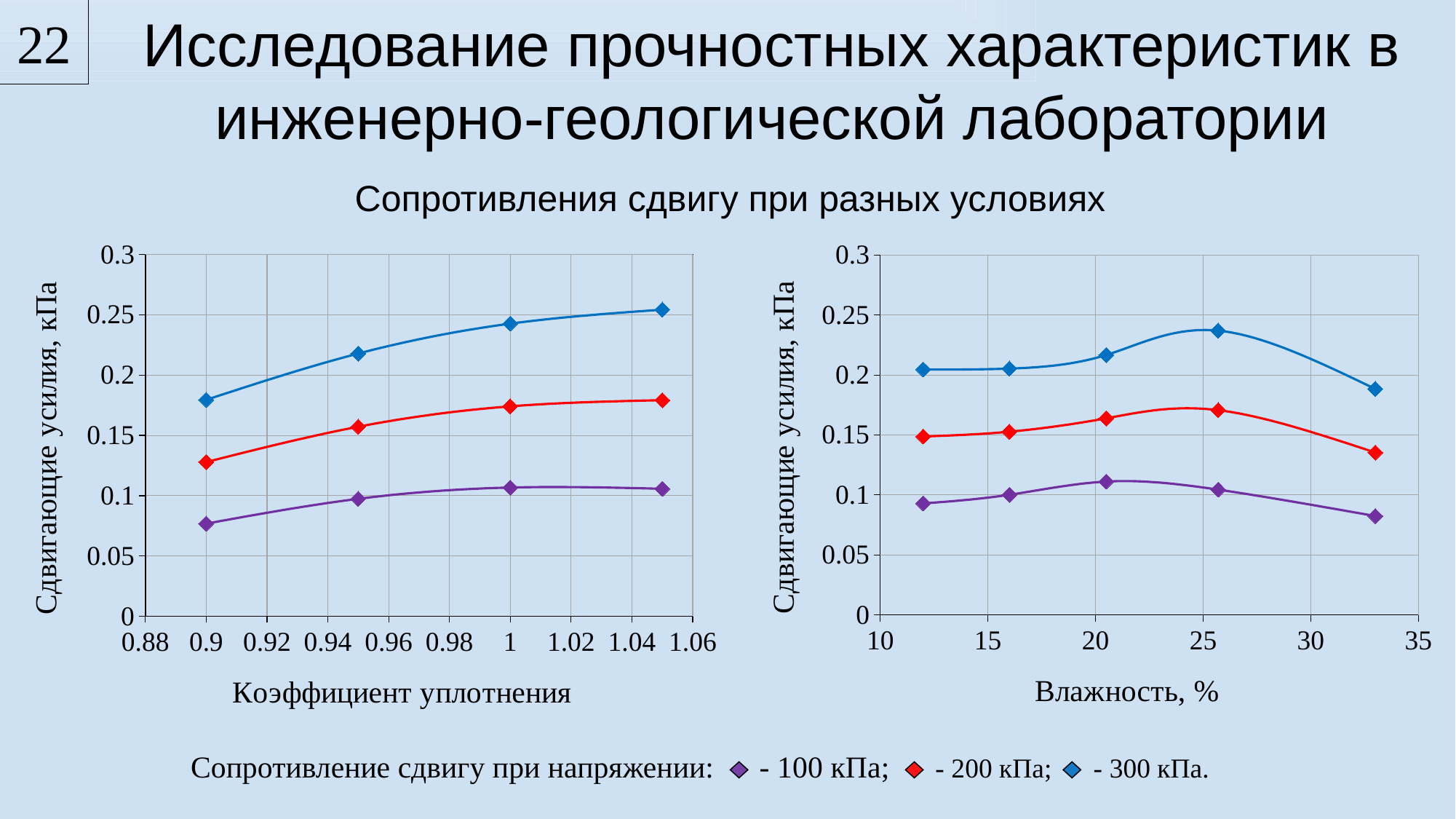
In the left chart (Коэффициент уплотнения), is the value for the 200 кПа series at 1 greater or less than 0.15? greater What is the x-axis title of the right chart? Влажность, % In the right chart (Влажность, %), is the value for the 300 кПа series at about 33% greater or less than 0.2? less In the left chart (Коэффициент уплотнения), do the values of the 300 кПа series rise or fall as the compaction coefficient increases? rise How many series does the legend list for the charts? 3 In the right chart (Влажность, %), is the value for the 100 кПа series at about 33% greater or less than 0.1? less What kind of chart is the left chart (Коэффициент уплотнения)? line chart In the right chart (Влажность, %), how many data points does each series have? 5 In the left chart (Коэффициент уплотнения), which series has the highest values? 300 кПа In the left chart (Коэффициент уплотнения), how many data points does each series have? 4 In the right chart (Влажность, %), does the 300 кПа series rise or fall between about 25% and 33% moisture? fall